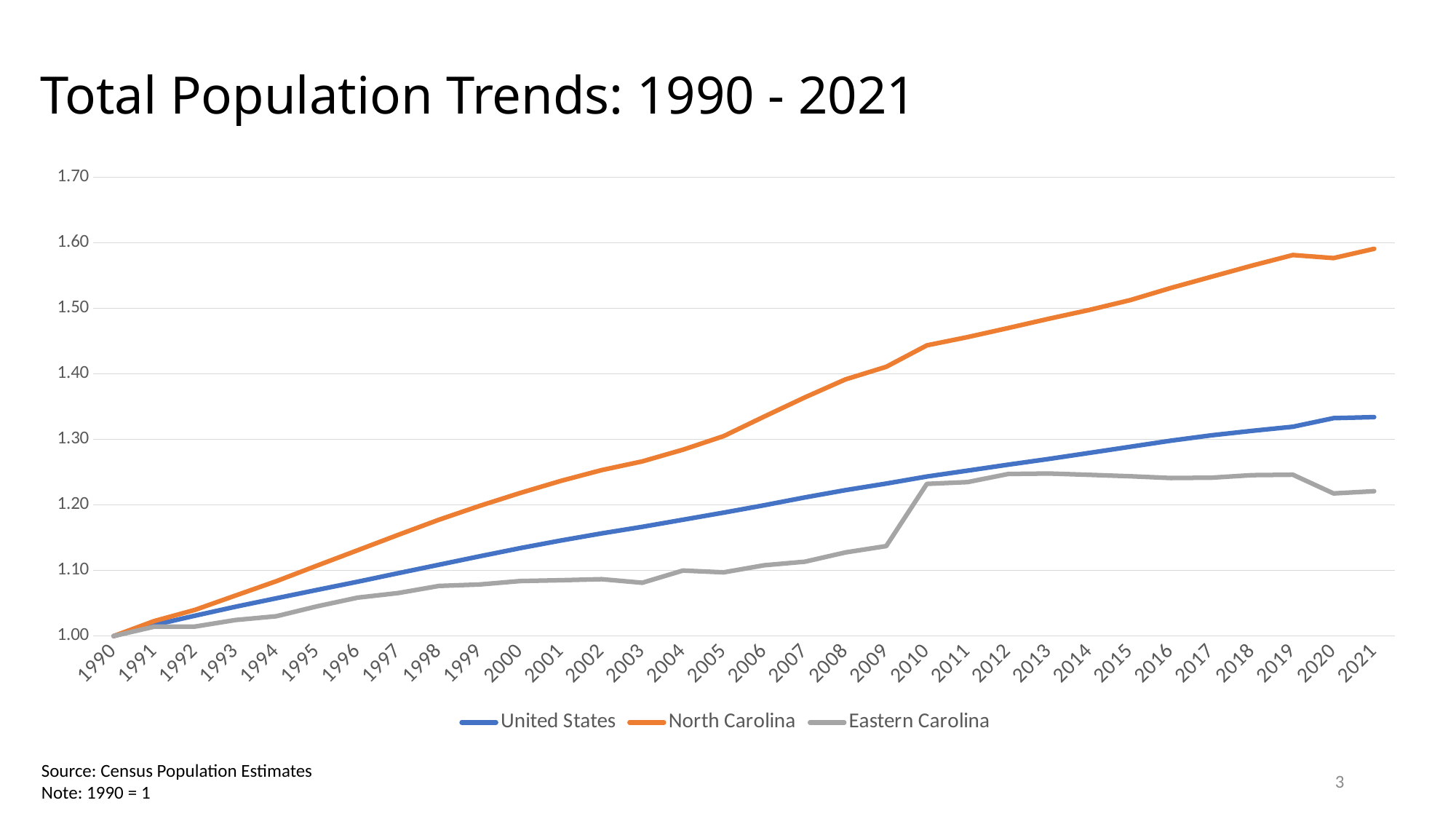
Which series has the lowest value in 2021? Eastern Carolina Does the North Carolina line generally rise or fall from 1990 to 2021? Rise How many years are plotted along the x axis? 32 How many series does the legend list? 3 What is the value for North Carolina in 1990? 1.00 Is the value for United States in 2021 greater or less than 1.40? less Which is larger in 2015, the value for North Carolina or the value for United States? North Carolina Is the value for North Carolina in 2021 greater or less than 1.50? greater What kind of chart is shown on the slide? Line chart Is the value for Eastern Carolina in 2009 greater or less than 1.20? less Which series has the highest value in 2021? North Carolina What colour is the line for Eastern Carolina? Gray